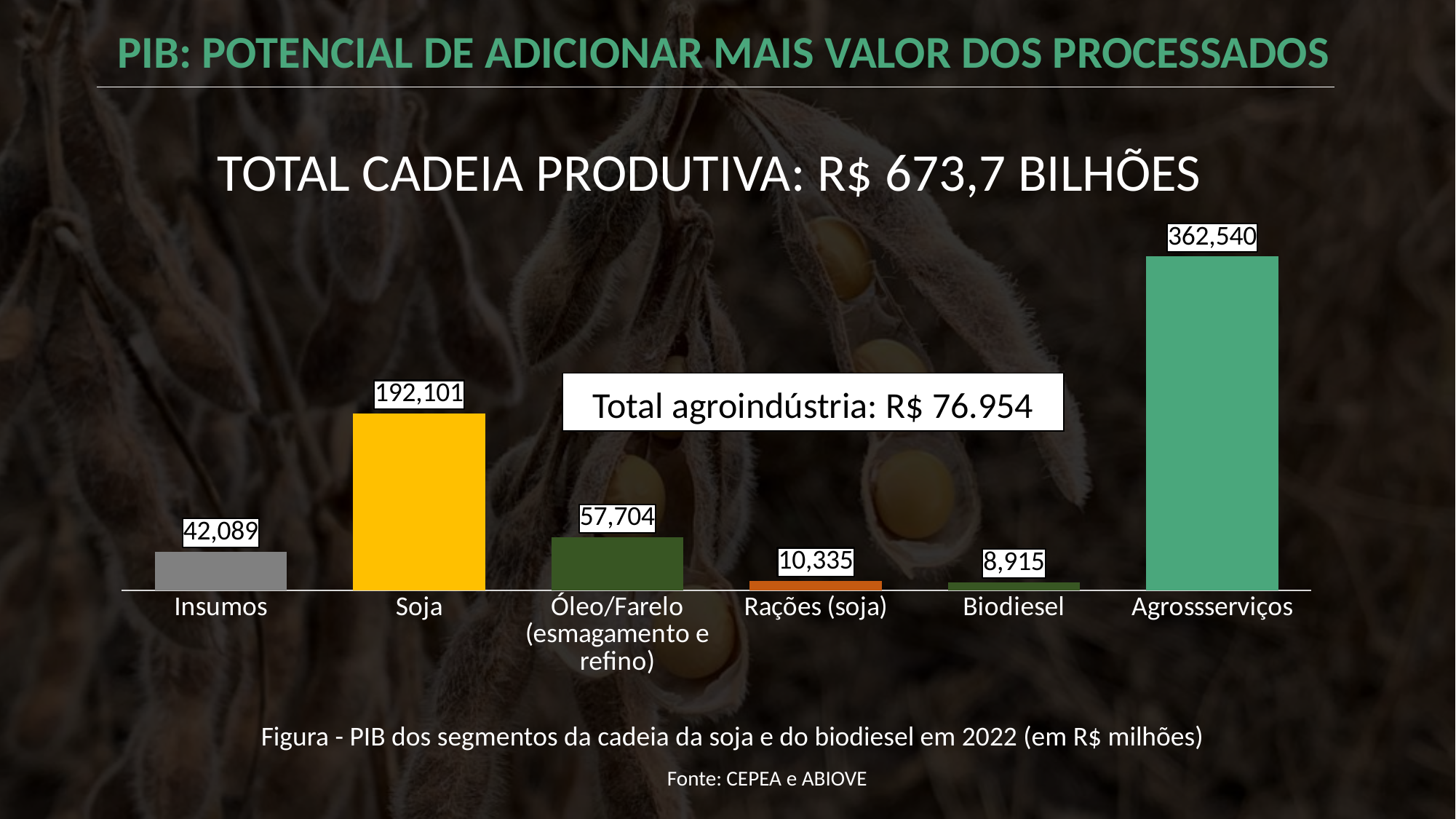
How many categories are shown in the chart? 6 What is the value for Rações (soja)? 10,335 What is the value for Óleo/Farelo (esmagamento e refino)? 57,704 Which is larger, the value for Insumos or the value for Óleo/Farelo (esmagamento e refino)? Óleo/Farelo (esmagamento e refino) Which category has the lowest value? Biodiesel Which category has the highest value? Agrossserviços What is the difference between the values for Soja and Insumos? 150,012 According to the text box on the chart, what is the total for agroindústria? R$ 76.954 What is the value for Soja? 192,101 What kind of chart is shown on the slide? Bar chart What is the difference between the values for Agrossserviços and Soja? 170,439 What is the value for Biodiesel? 8,915